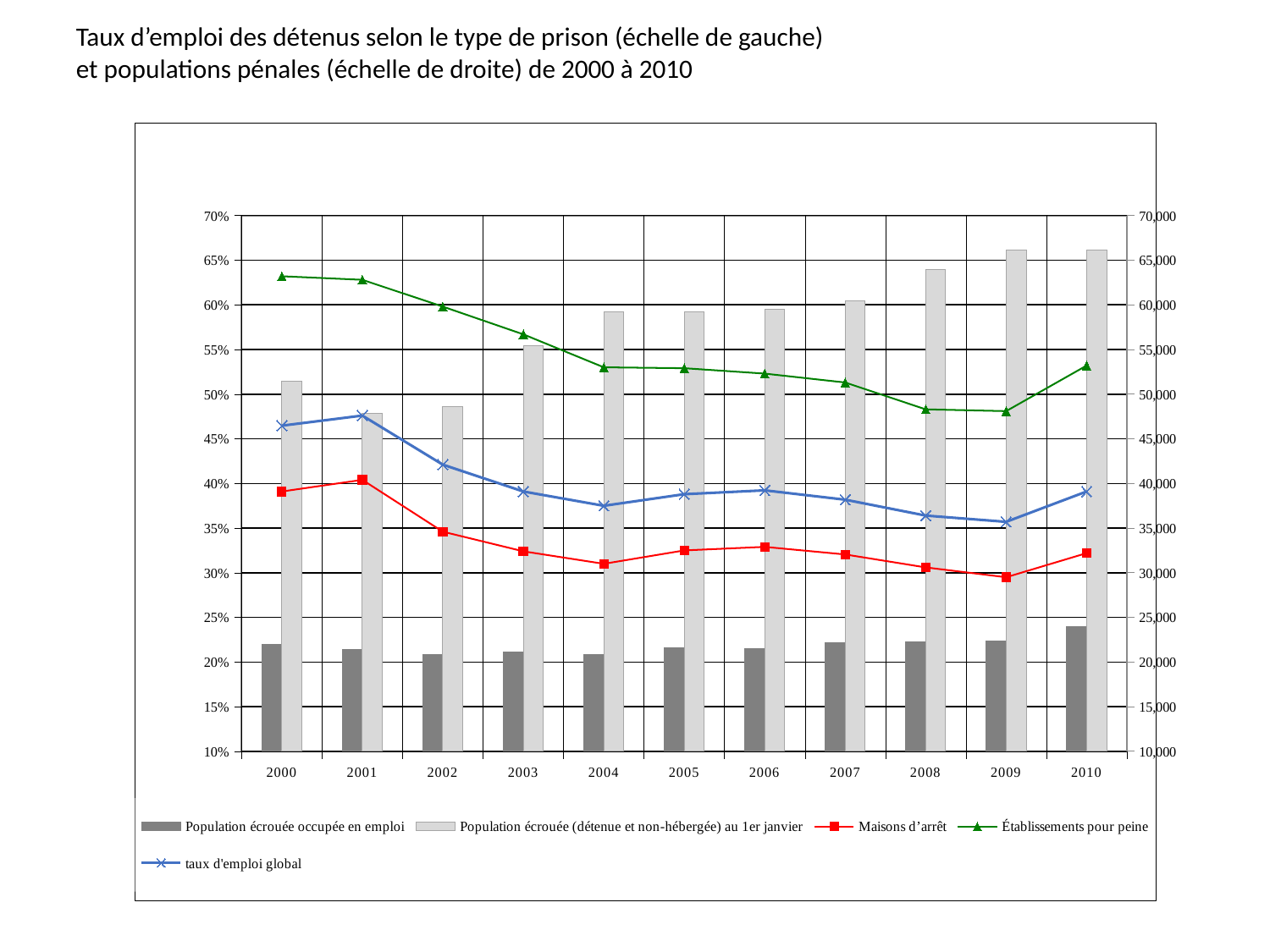
In which year is the 'Population écrouée occupée en emploi' bar highest? 2010 Is the 'Population écrouée (détenue et non-hébergée) au 1er janvier' bar for 2010 greater or less than 65,000? greater Which is larger in 2000: the employment rate for 'Établissements pour peine' or for 'Maisons d'arrêt'? Établissements pour peine Is the value for 'Établissements pour peine' in 2000 greater or less than 60%? greater Is the 'taux d'emploi global' value for 2002 greater or less than 40%? greater What kind of chart is shown on the slide? A combined bar and line chart Which series is drawn with a green line and triangle markers? Établissements pour peine How many series does the legend list? 5 How many years are shown on the x axis? 11 Does the 'Établissements pour peine' employment rate rise or fall from 2000 to 2009? Fall In which year is the 'Maisons d'arrêt' employment rate highest? 2001